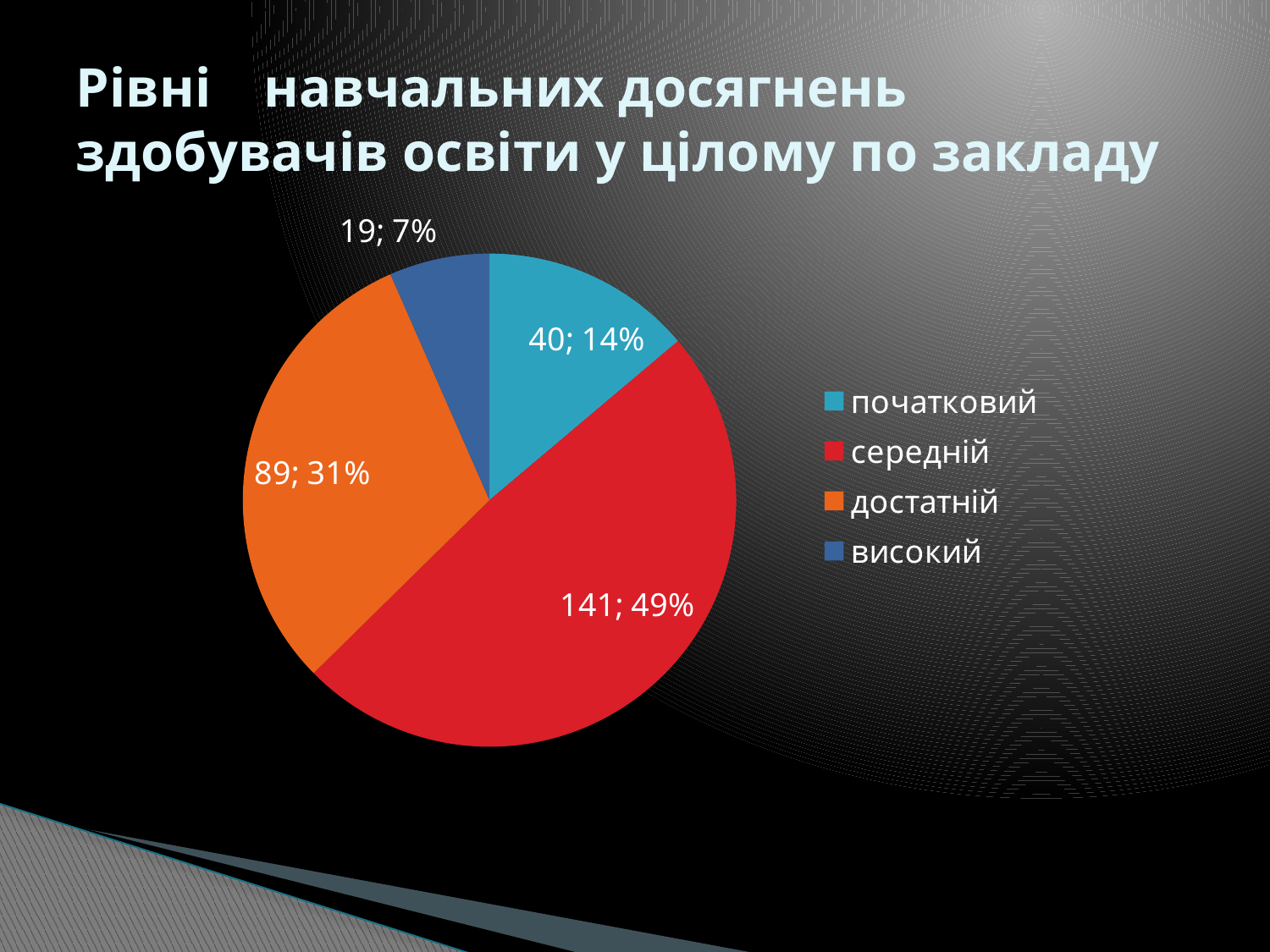
Which is larger, the value for початковий or the value for високий? початковий Which category has the largest slice? середній What is the value for високий? 19 What kind of chart is shown on the slide? pie chart What is the value for достатній? 89 What is the value for початковий? 40 What is the value for середній? 141 How many categories does the pie chart have? 4 Which category has the smallest slice? високий What is the difference between the values for середній and достатній? 52 What share of the pie does початковий represent? 14% What share of the pie does достатній represent? 31%